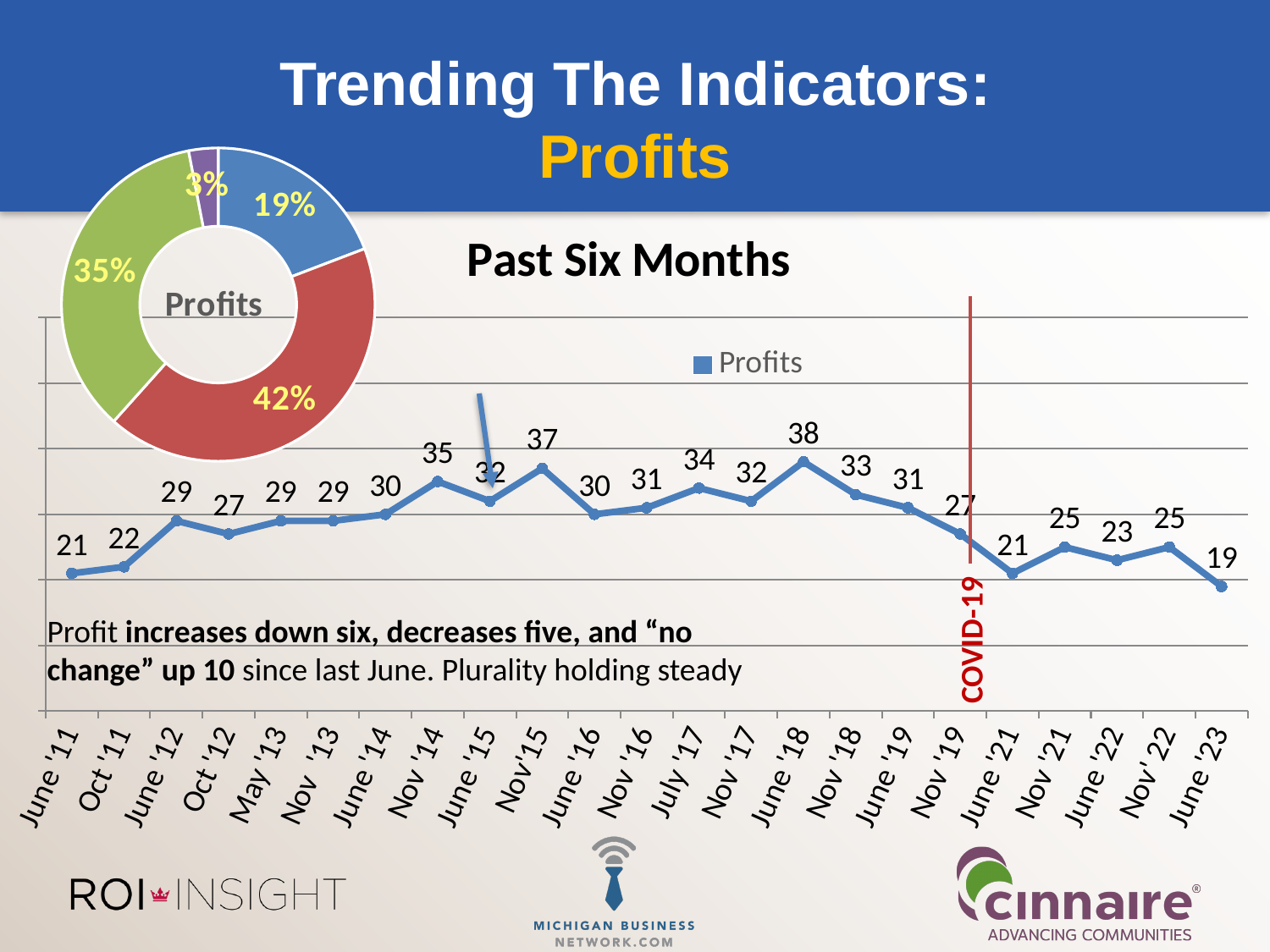
In the 'Past Six Months' line chart, what is the Profits value for Nov '15? 37 What kind of chart is the 'Past Six Months' chart? line chart In the 'Past Six Months' line chart, which period has the highest Profits value? June '18 In the 'Past Six Months' line chart, which is larger, the Profits value for Nov '14 or for June '15? Nov '14 In the 'Past Six Months' line chart, what is the difference between the Profits values for June '18 and June '23? 19 In the 'Profits' donut chart, what is the percentage of the largest slice? 42% In the 'Past Six Months' line chart, what is the Profits value for June '23? 19 In the 'Past Six Months' line chart, how many data points are plotted? 23 In the 'Past Six Months' line chart, what is the Profits value for June '18? 38 In the 'Past Six Months' line chart, do the Profits values rise or fall from June '19 to June '21? fall In the 'Profits' donut chart, how many slices are there? 4 In the 'Past Six Months' line chart, which period has the lowest Profits value? June '23